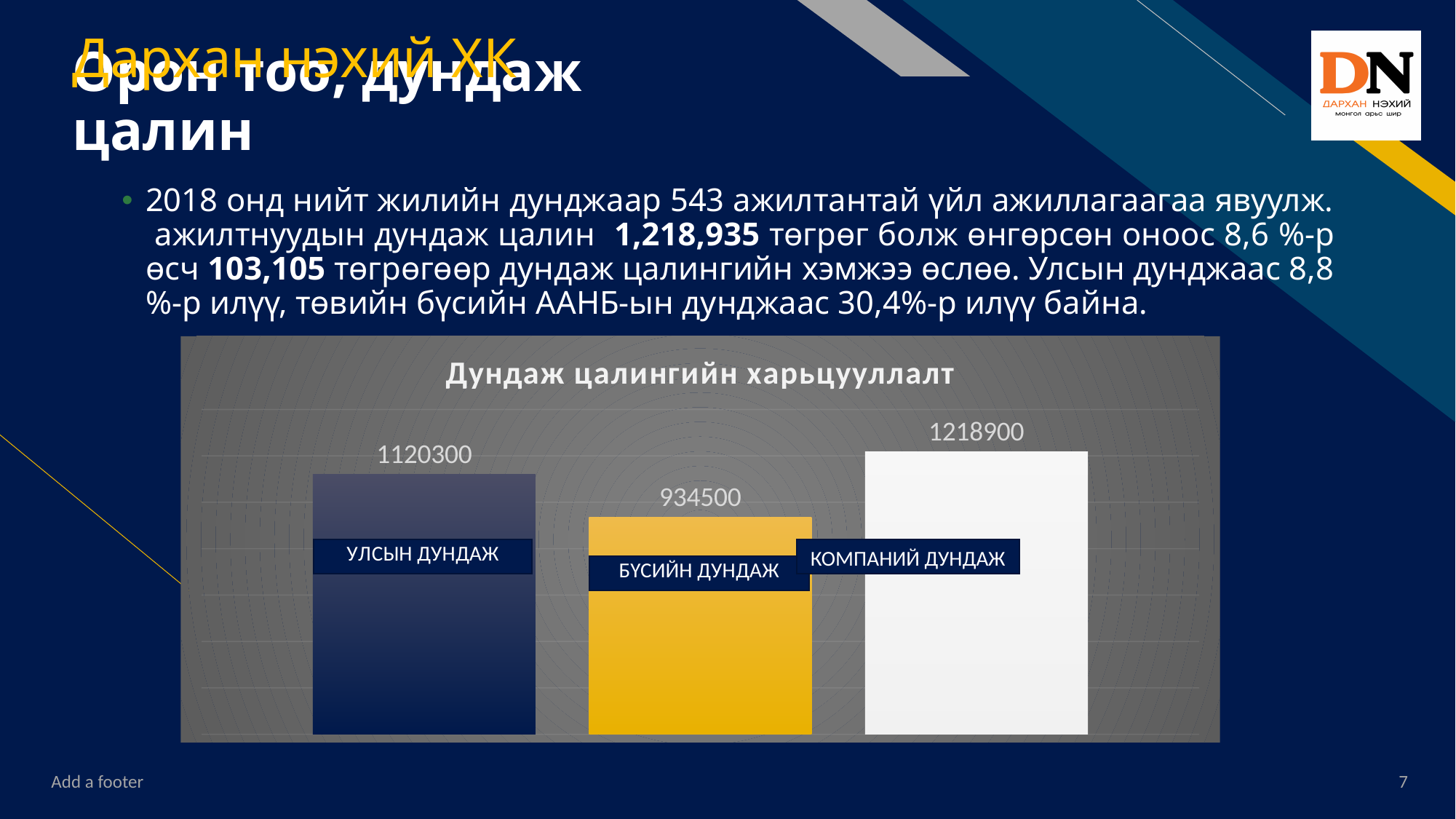
Which is larger, the value for УЛСЫН ДУНДАЖ or the value for БҮСИЙН ДУНДАЖ? УЛСЫН ДУНДАЖ What is the title of the chart? Дундаж цалингийн харьцууллалт What is the value for УЛСЫН ДУНДАЖ in the chart? 1120300 What kind of chart is shown on the slide? Bar chart What is the difference between the values for КОМПАНИЙ ДУНДАЖ and УЛСЫН ДУНДАЖ? 98600 What is the value for КОМПАНИЙ ДУНДАЖ in the chart? 1218900 Which category has the lowest value in the chart? БҮСИЙН ДУНДАЖ Which category has the highest value in the chart? КОМПАНИЙ ДУНДАЖ How many bars are shown in the chart? 3 What is the difference between the values for УЛСЫН ДУНДАЖ and БҮСИЙН ДУНДАЖ? 185800 What is the value for БҮСИЙН ДУНДАЖ in the chart? 934500 What is the difference between the values for КОМПАНИЙ ДУНДАЖ and БҮСИЙН ДУНДАЖ? 284400